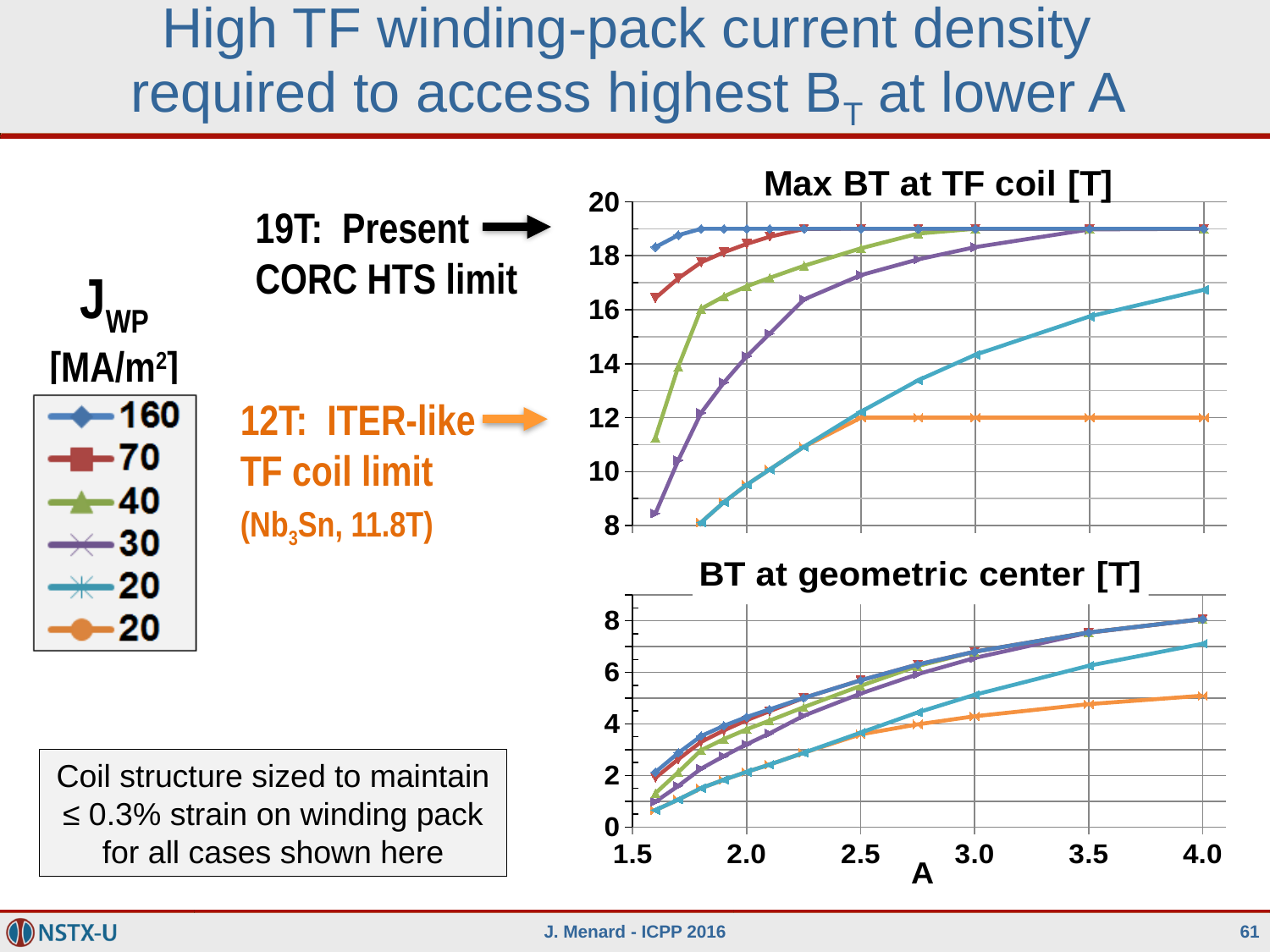
What is the label of the x axis shared by the two charts? A In the 'Max BT at TF coil [T]' chart, is the value of the teal 20 series at A = 4.0 greater or less than 16? greater In the 'BT at geometric center [T]' chart, is the value of the 30 series at A = 1.6 greater or less than 2? less In the 'Max BT at TF coil [T]' chart, is the value of the 30 series at A = 1.6 greater or less than 10? less In the 'BT at geometric center [T]' chart, do the values of the 160 series rise or fall as A increases? rise In the 'Max BT at TF coil [T]' chart, what is the value of the orange 20 series at A = 4.0? 12 How many series does the legend list for the charts? 6 In the 'Max BT at TF coil [T]' chart, at A = 2.0, which series has the larger value: 160 or 30? 160 In the 'BT at geometric center [T]' chart, at A = 4.0, which has the larger value: the teal 20 series or the orange 20 series? teal 20 series What kind of chart is the 'Max BT at TF coil [T]' chart? line chart